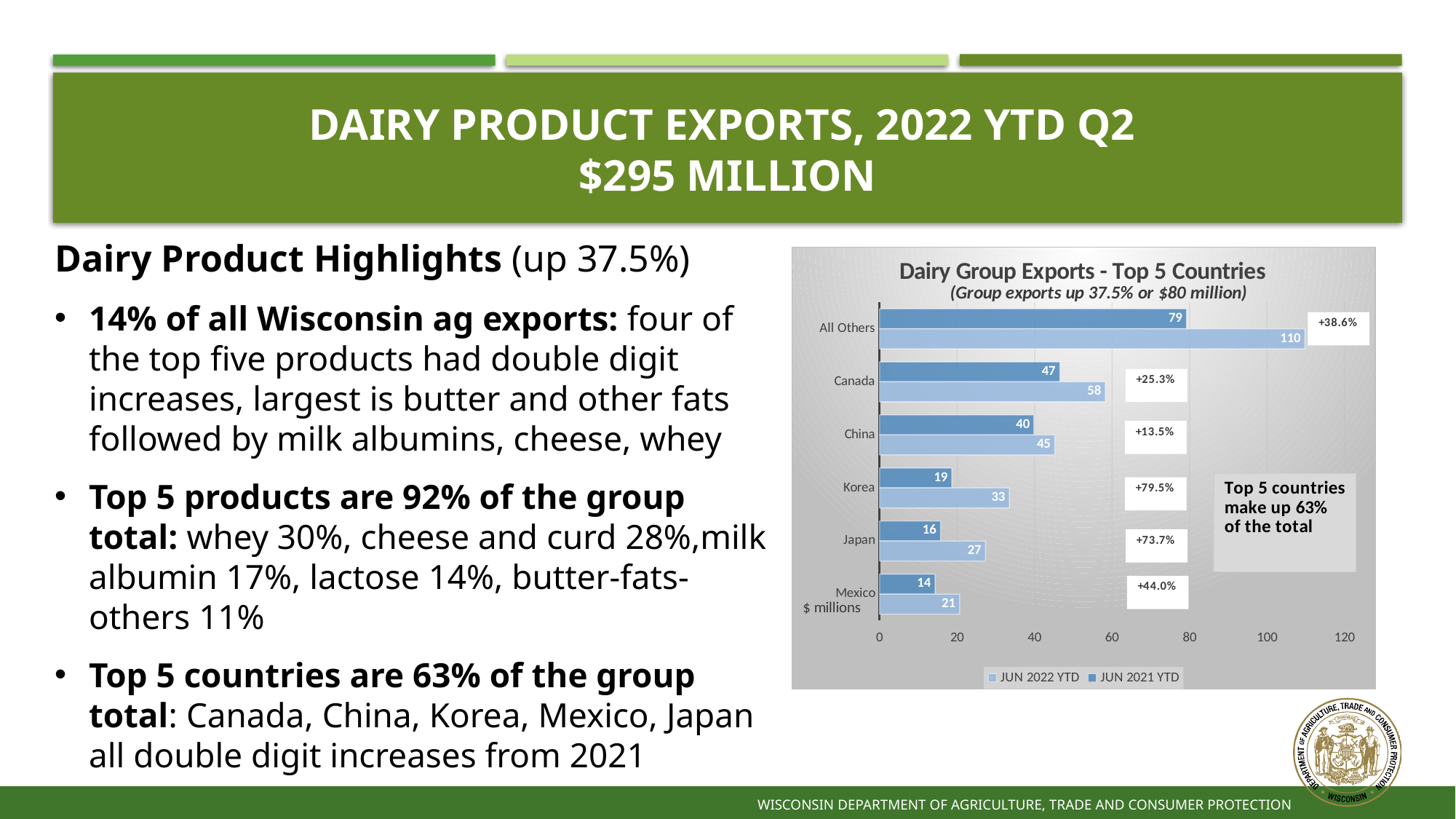
How many series does the legend list? 2 How many categories are shown on the chart? 6 What kind of chart is shown? bar chart Which is larger, the JUN 2022 YTD value for Japan or the JUN 2022 YTD value for Korea? Korea Which category has the lowest JUN 2021 YTD value? Mexico What is the JUN 2021 YTD value for China? 40 What is the difference between the JUN 2022 YTD and JUN 2021 YTD values for Korea? 14 Which category has the highest JUN 2022 YTD value? All Others What is the title of the chart? Dairy Group Exports - Top 5 Countries What is the JUN 2022 YTD value for Canada? 58 What percentage change is shown for Korea? +79.5% What is the JUN 2022 YTD value for Mexico? 21